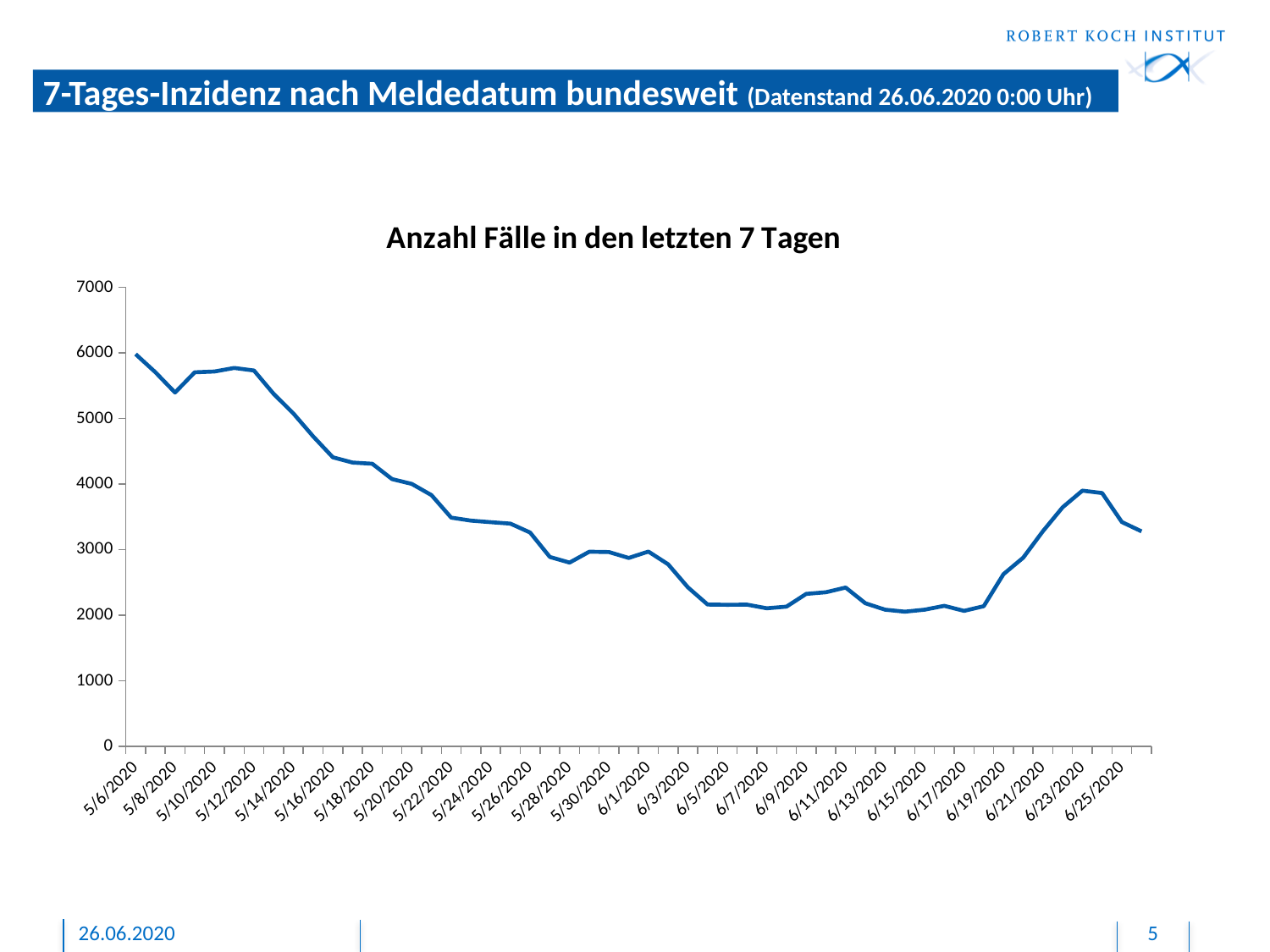
Is the value for 6/13/2020 greater or less than 3000? less What is the title of the chart? Anzahl Fälle in den letzten 7 Tagen Is the value for 6/5/2020 greater or less than 3000? less What is the highest value shown on the y-axis of the chart? 7000 Is the value for 5/6/2020 greater or less than 5000? greater What kind of chart is shown on the slide? line chart Do the values rise or fall between 6/17/2020 and 6/23/2020? rise Which date has the larger value, 5/6/2020 or 6/25/2020? 5/6/2020 Do the values rise or fall between 5/6/2020 and 6/5/2020? fall Which date has the larger value, 6/5/2020 or 6/23/2020? 6/23/2020